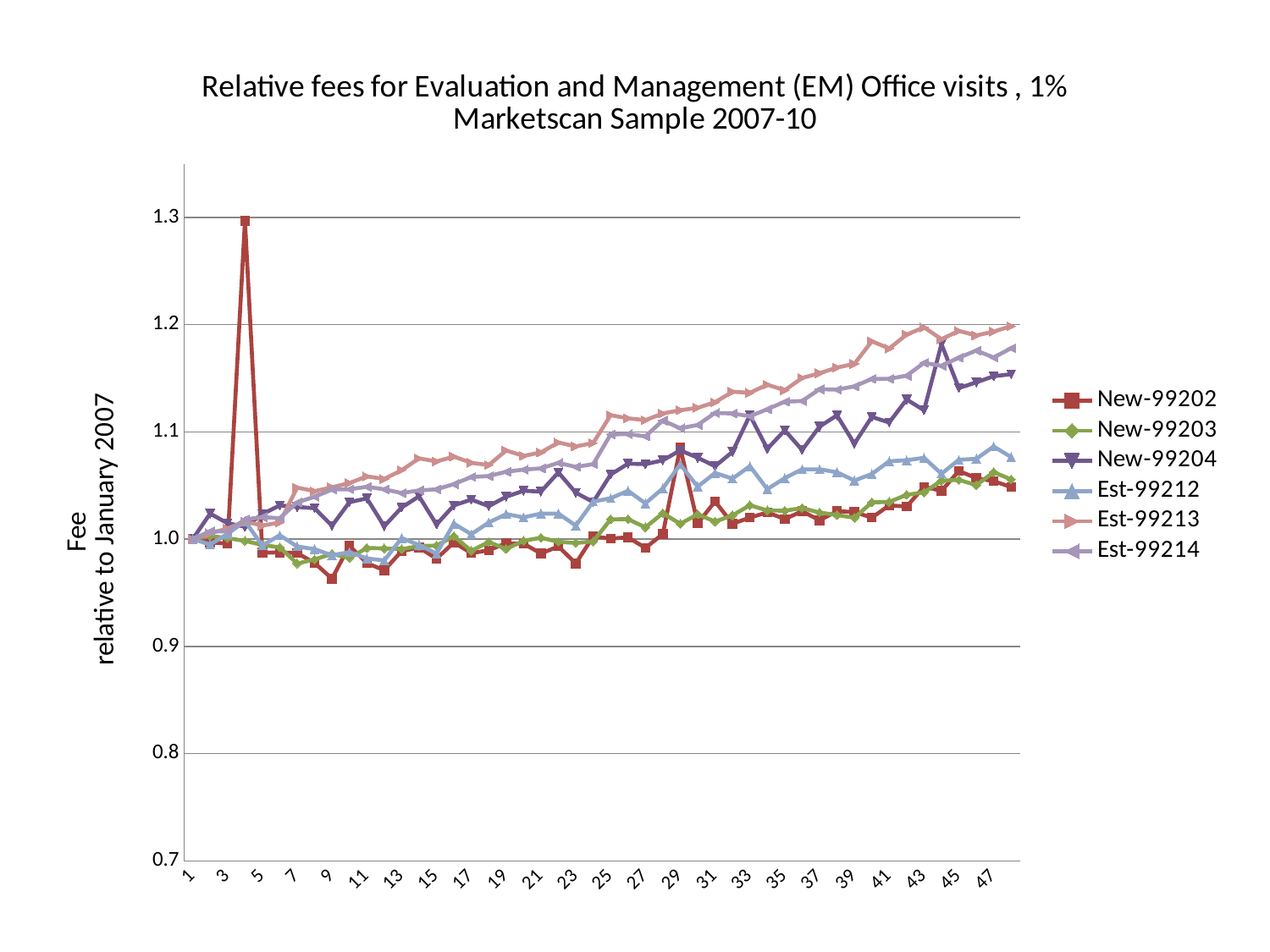
Which series is listed last in the legend? Est-99214 What kind of chart is shown on the slide? line chart Does the Est-99213 series generally rise or fall from left to right along the x axis? rise Is the value for Est-99214 at x = 47 greater or less than 1.1? greater Which series has the highest value at x = 47? Est-99213 Is the value for New-99202 at x = 4 greater or less than 1.2? greater Is the value for Est-99213 at x = 47 greater or less than 1.1? greater At x = 47, which is larger, Est-99213 or New-99203? Est-99213 What is the label on the vertical axis? Fee relative to January 2007 How many series does the legend list? 6